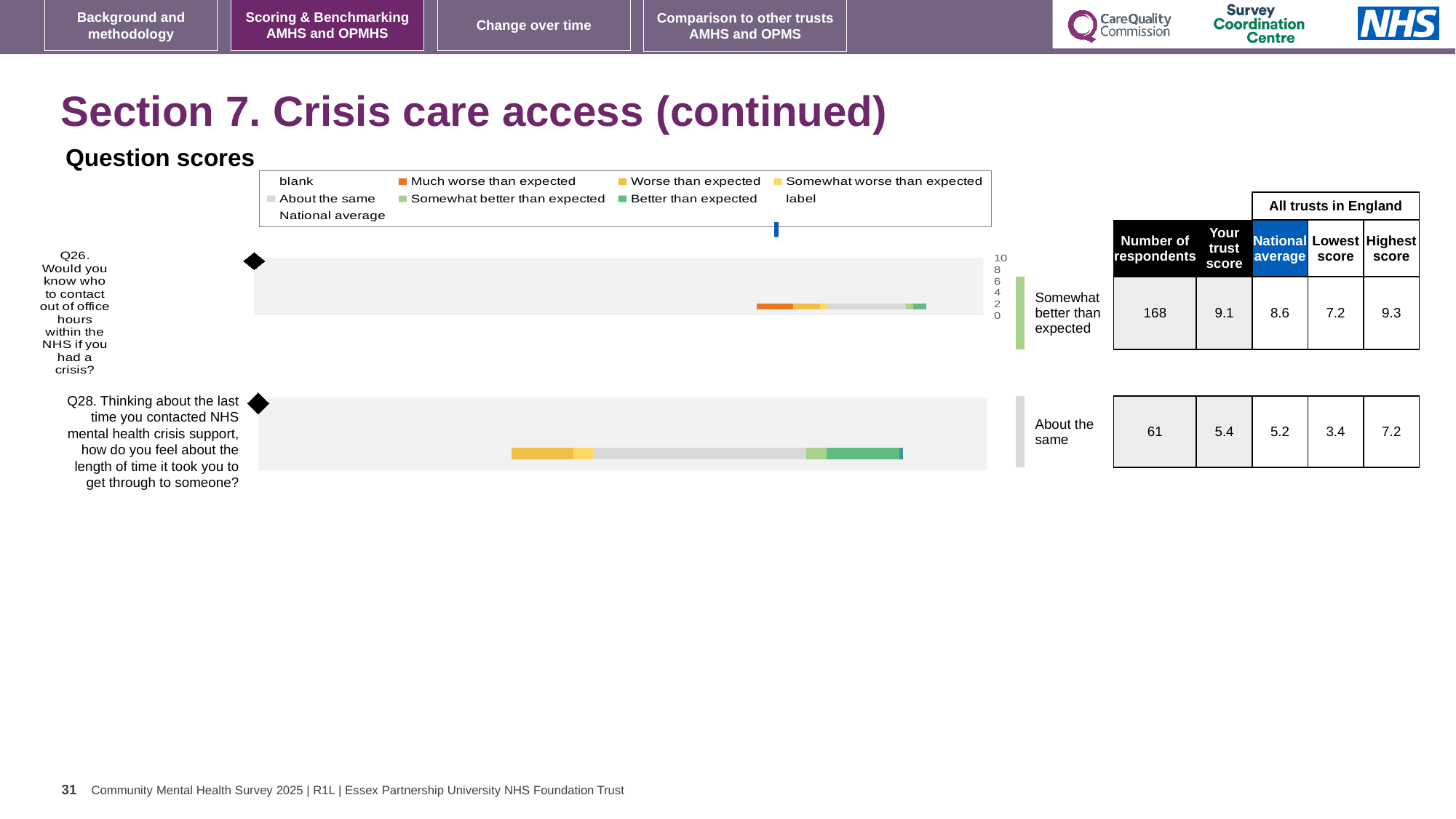
What is the national average shown for Q28 (how do you feel about the length of time it took you to get through to someone?)? 5.2 How many questions are plotted in the question scores chart? 2 How many respondents are shown for Q26? 168 What kind of chart is used to show the question scores for Q26 and Q28? bar chart What is the difference between the trust score and the national average for Q28? 0.2 What is the trust score shown for Q26 (Would you know who to contact out of office hours within the NHS if you had a crisis?)? 9.1 What is the lowest score among all trusts in England shown for Q26? 7.2 What colour does the legend use for 'Much worse than expected'? orange What benchmark category label is shown next to the bar for Q26? Somewhat better than expected How many entries does the legend of the question scores chart list? 9 Which is larger for Q26, the trust score or the national average? trust score What is the highest score among all trusts in England shown for Q28? 7.2